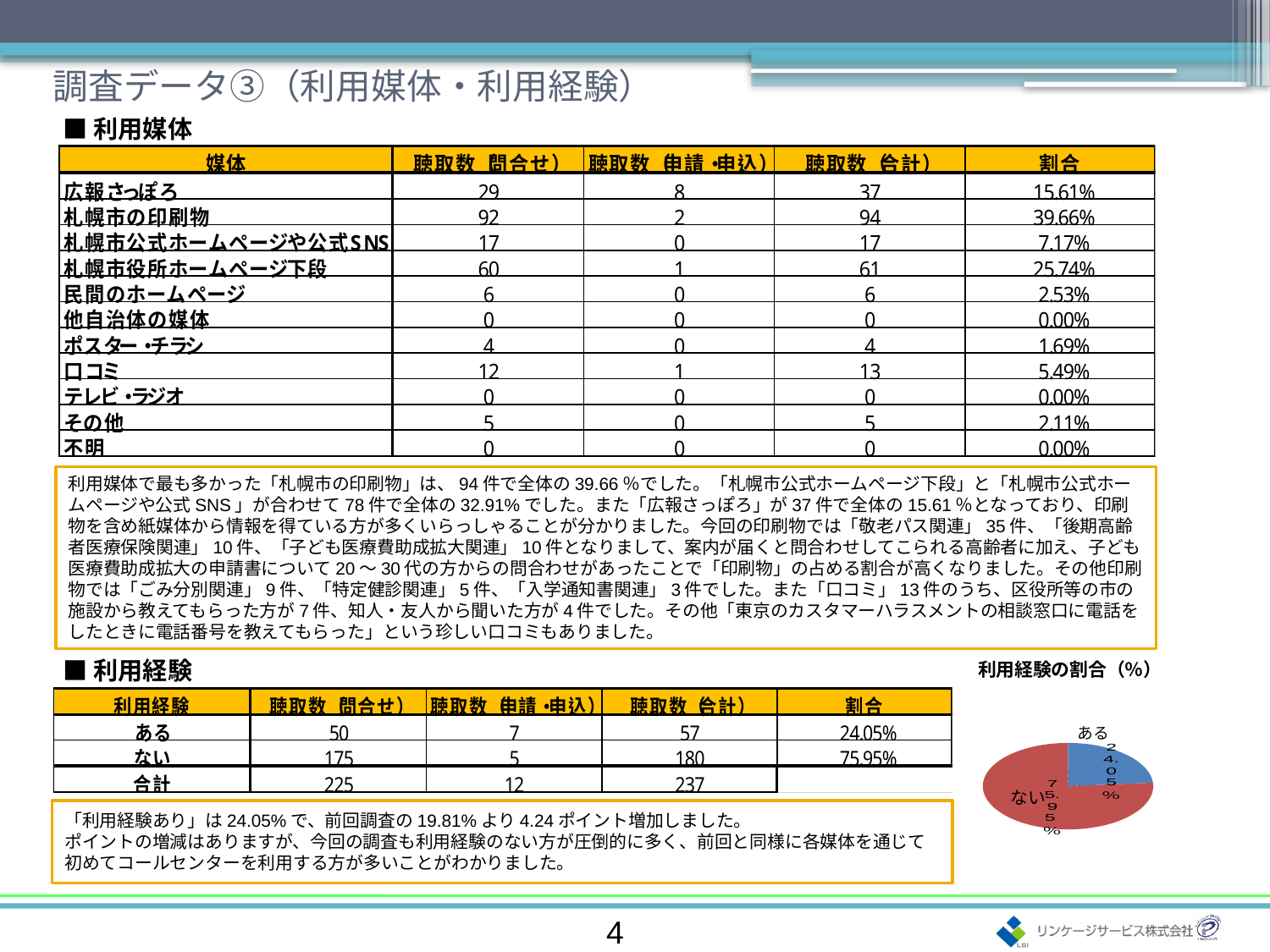
In the pie chart 利用経験の割合（%）, how many slices are there? 2 What is the title of the pie chart on the slide? 利用経験の割合（%） In the pie chart 利用経験の割合（%）, which slice is the smallest? ある In the pie chart 利用経験の割合（%）, what is the share for ある? 24.05% In the pie chart 利用経験の割合（%）, what is the share for ない? 75.95% In the pie chart 利用経験の割合（%）, which slice is the largest? ない In the pie chart 利用経験の割合（%）, what is the difference in percentage points between ない and ある? 51.90 In the pie chart 利用経験の割合（%）, what colour is the ない slice? red What kind of chart is shown on the slide under the heading 利用経験の割合（%）? pie chart In the pie chart 利用経験の割合（%）, which is larger, ある or ない? ない